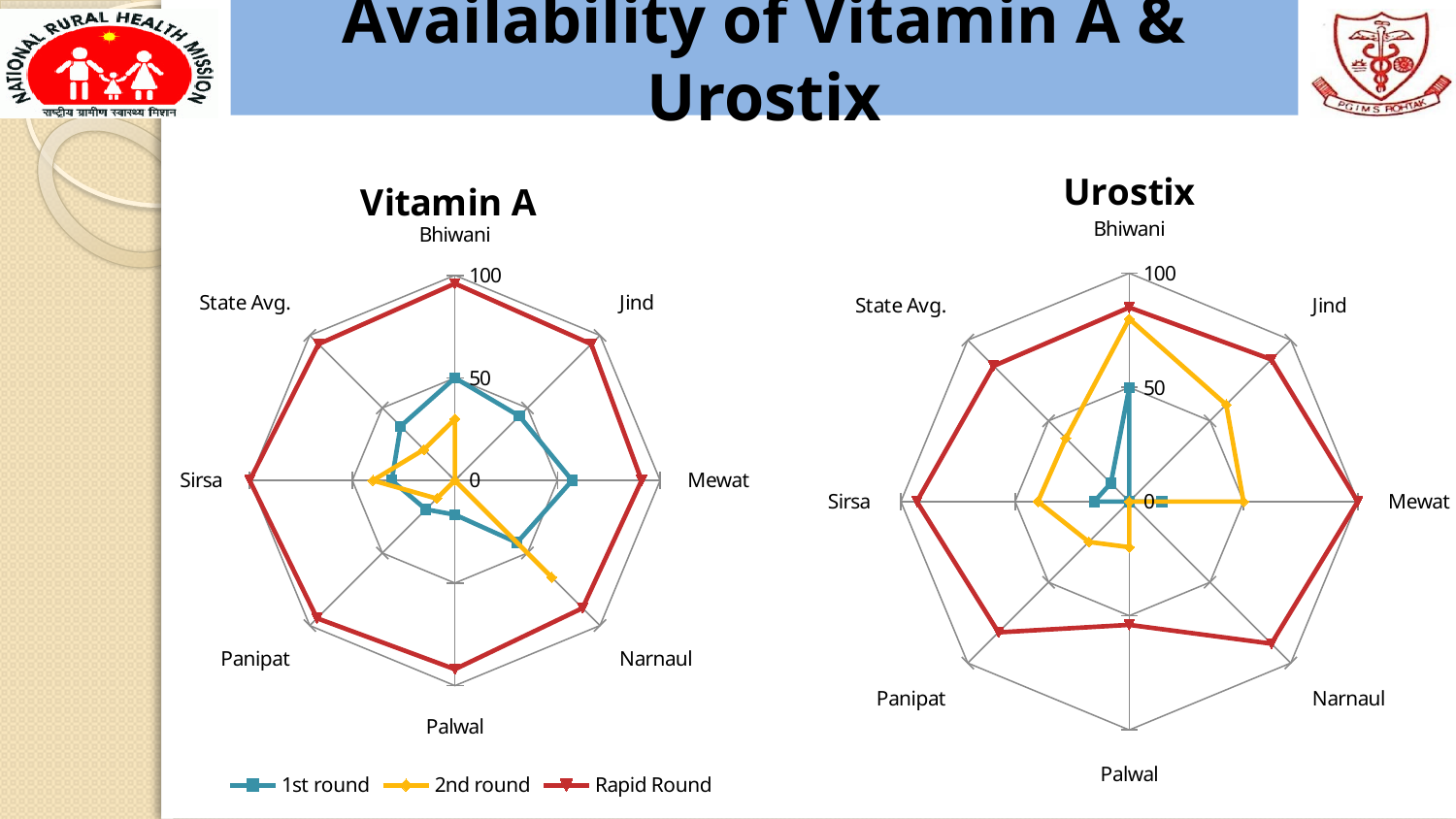
What are the three series named in the legend of the Vitamin A chart? 1st round, 2nd round, Rapid Round How many series does the legend list for the Vitamin A chart? 3 In the Vitamin A chart, is the Rapid Round value for Mewat greater or less than 50? greater In the Vitamin A chart, which is larger for Bhiwani: the 1st round value or the 2nd round value? 1st round How many categories (axes) does the Urostix chart have? 8 In the Urostix chart, which is larger for Narnaul: the Rapid Round value or the 2nd round value? Rapid Round In the Vitamin A chart, is the 1st round value for Palwal greater or less than 50? less In the Vitamin A chart, is the 2nd round value for Narnaul greater or less than 50? greater What type of chart is the Vitamin A chart? Radar chart In the Urostix chart, which category has the highest 2nd round value? Bhiwani